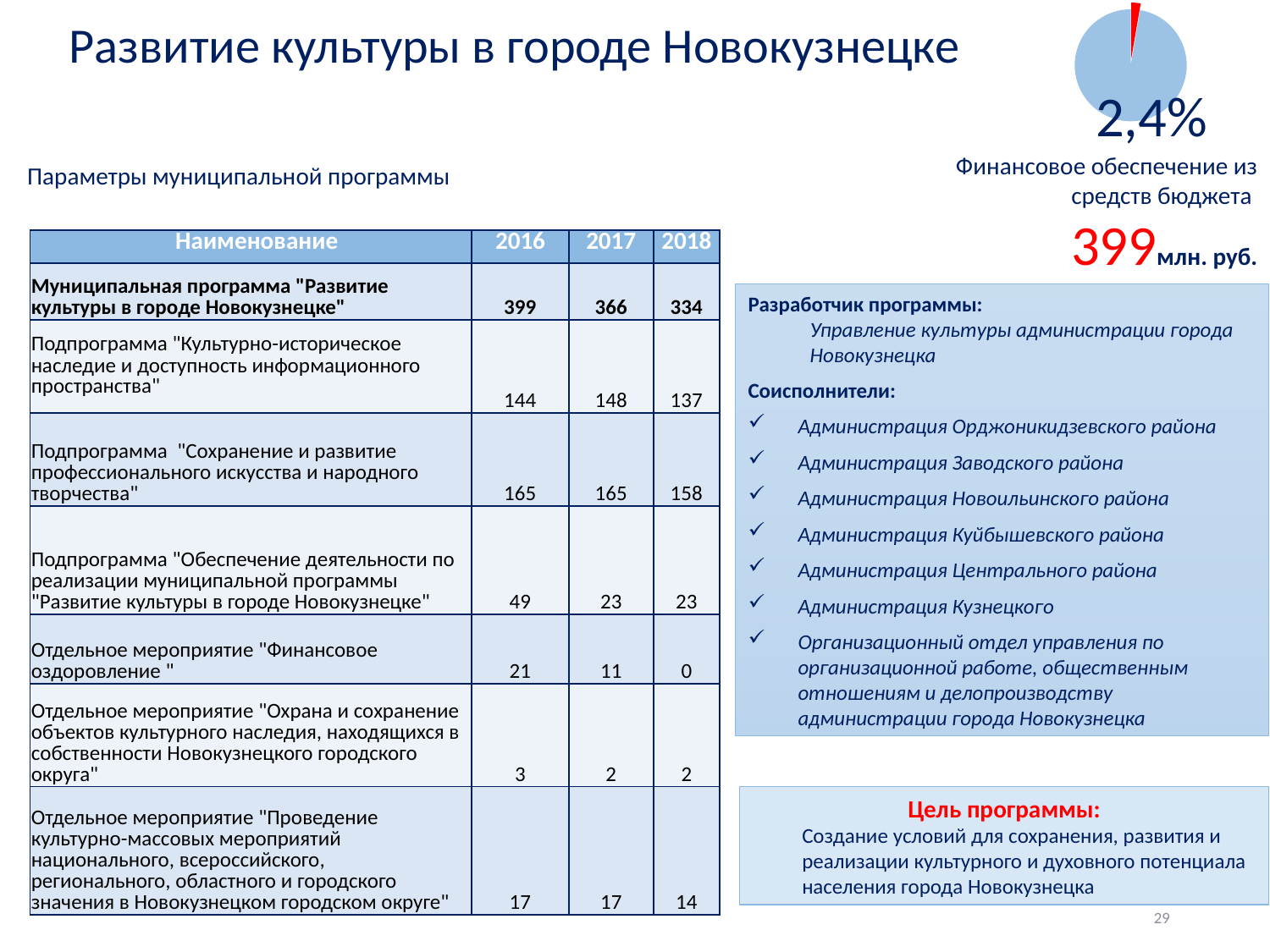
How many slices does the pie chart in the top right corner have? 2 What colour is the large slice of the pie chart in the top right corner? light blue Is the share shown by the red slice of the pie chart greater or less than 50%? less What colour is the small slice of the pie chart labelled 2,4%? red In the pie chart, which slice is larger: the light blue slice or the red slice? the light blue slice What kind of chart is shown in the top right corner of the slide? pie chart What share of the pie chart does the small red slice represent? 2,4%